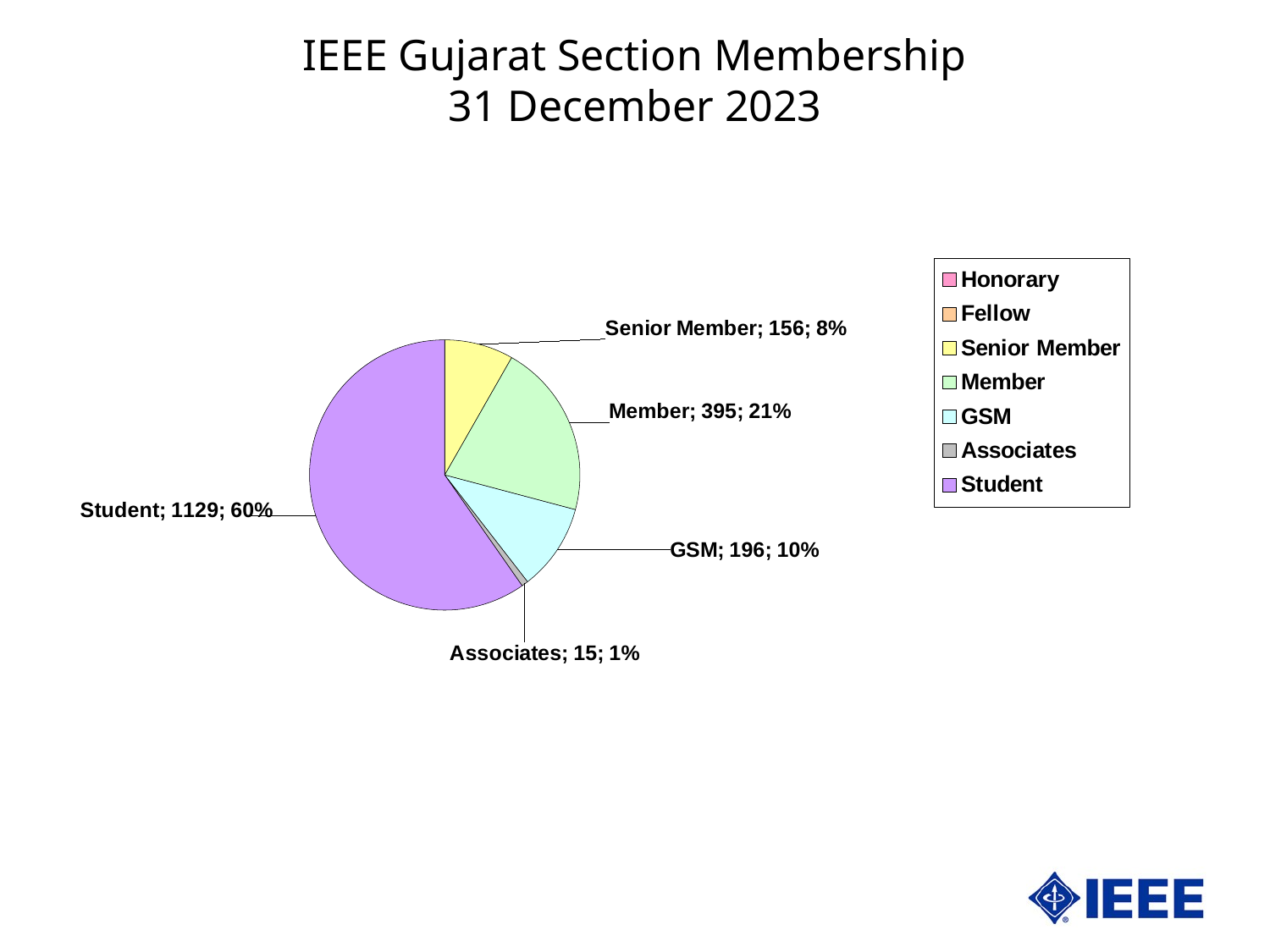
What value is shown for GSM? 196 Which is larger, the Senior Member value or the GSM value? GSM What value is shown for Associates? 15 What percentage share of the pie does Senior Member hold? 8% What is the difference between the Member value and the GSM value? 199 Which category has the largest slice of the pie? Student What type of chart is shown on the slide? pie chart What percentage share of the pie does Student hold? 60% Which labelled category has the smallest slice of the pie? Associates How many entries does the legend list? 7 How many members does the Student slice represent? 1129 What value is shown for the Member slice? 395